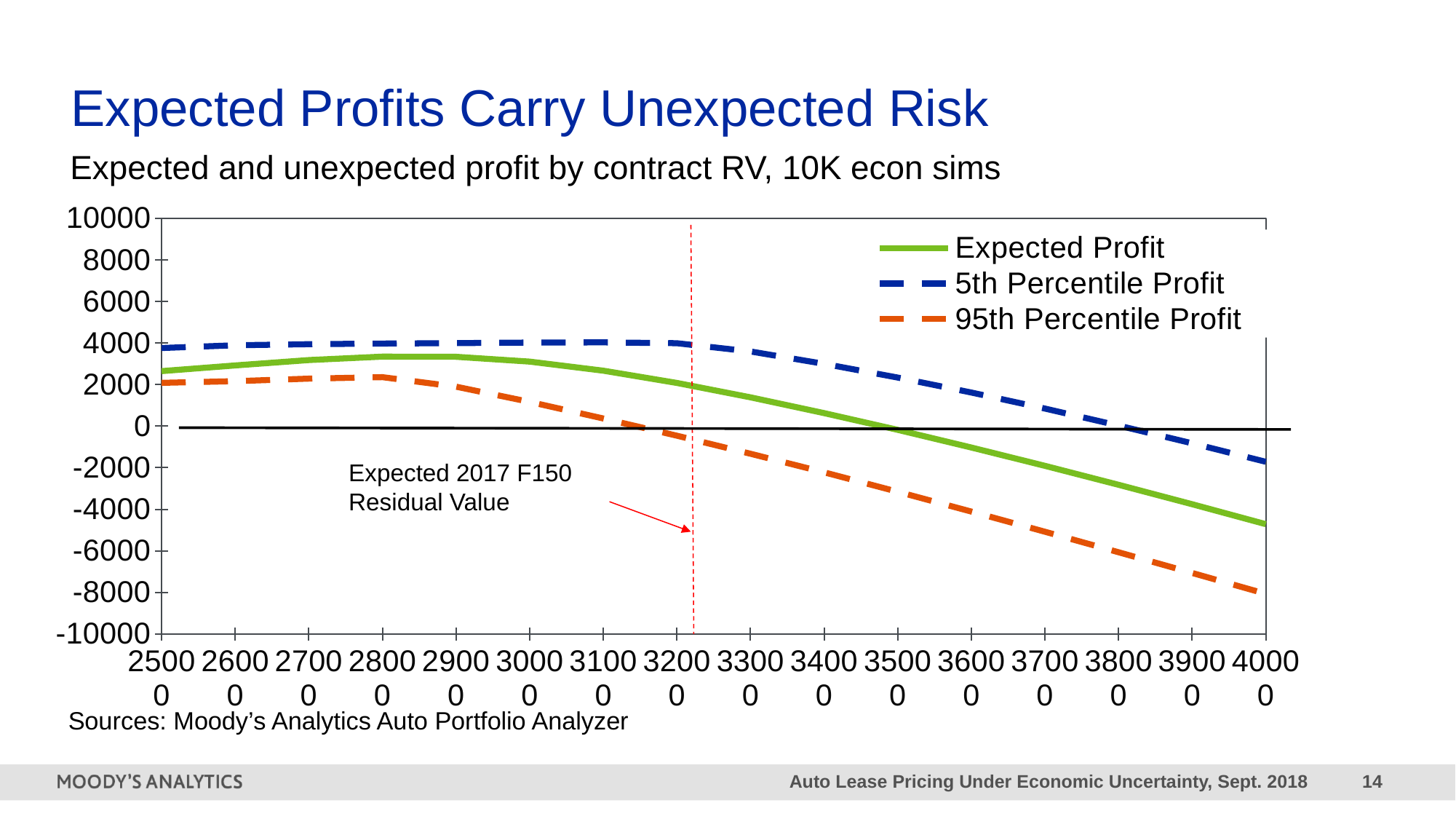
At 40000 on the x axis, which is higher: 5th Percentile Profit or 95th Percentile Profit? 5th Percentile Profit Is the value of 95th Percentile Profit at 40000 greater or less than -6000? less Does the 95th Percentile Profit line rise or fall between 30000 and 40000 on the x axis? fall Does the Expected Profit line rise or fall between 30000 and 40000 on the x axis? fall What kind of chart is shown on the slide? line chart What does the vertical dashed red line on the chart mark, according to the annotation? Expected 2017 F150 Residual Value Is the value of Expected Profit at 40000 greater or less than -4000? less At 30000 on the x axis, which is higher: Expected Profit or 95th Percentile Profit? Expected Profit How many series does the legend list? 3 Is the value of 5th Percentile Profit at 40000 greater or less than 0? less How many tick labels are shown along the x axis? 16